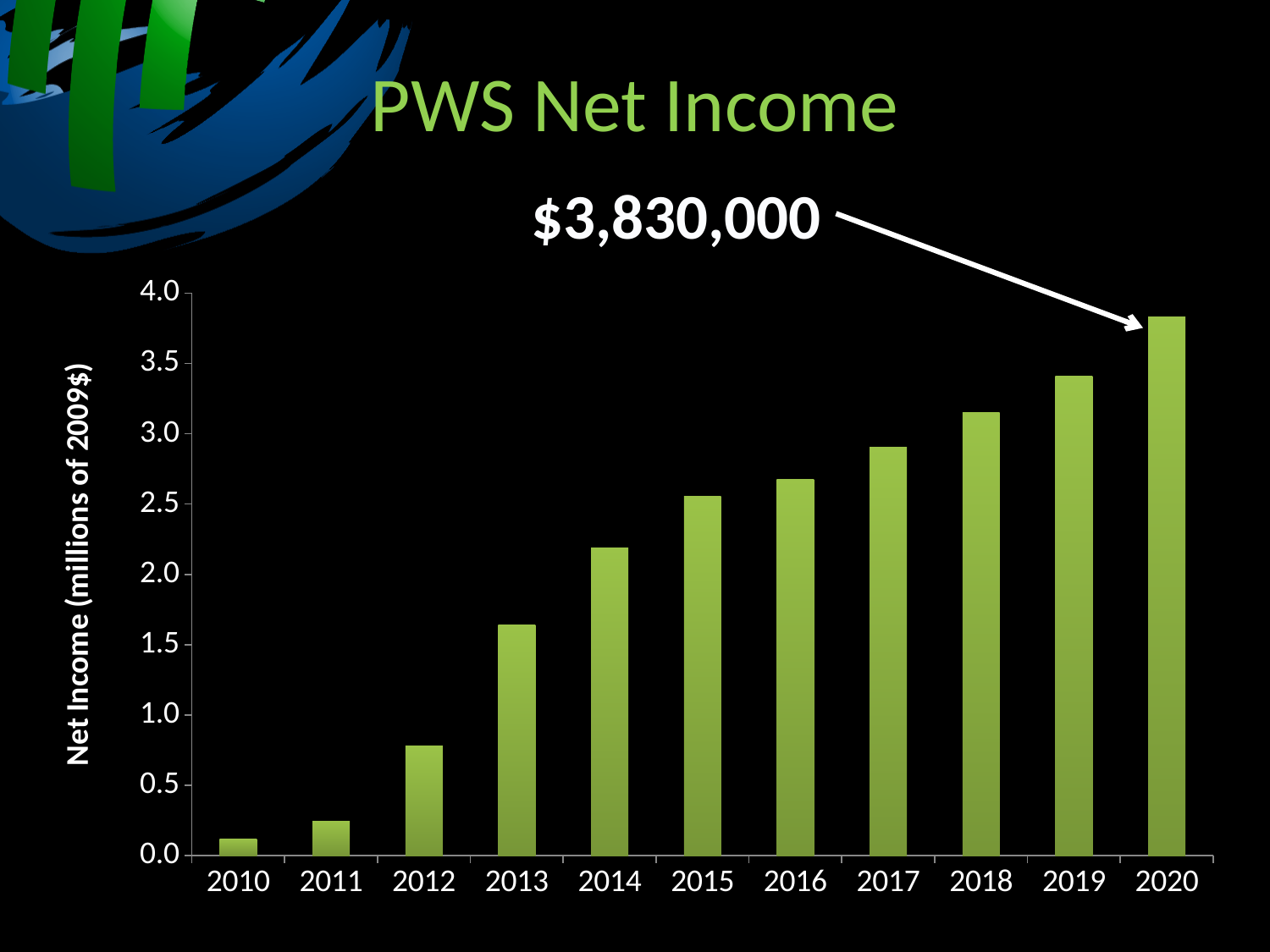
What is the net income value annotated for 2020? $3,830,000 Which year has the lowest net income? 2010 Is the value for 2017 greater or less than 3.0? less Is the value for 2013 greater or less than 1.5? greater What kind of chart is shown on the slide? Bar chart Which year has the highest net income? 2020 Is the value for 2018 greater or less than 3.0? greater Do the net income values rise or fall from 2010 to 2020? Rise How many years are shown on the x axis? 11 Which year has the larger net income, 2012 or 2015? 2015 What is the label on the y axis? Net Income (millions of 2009$)